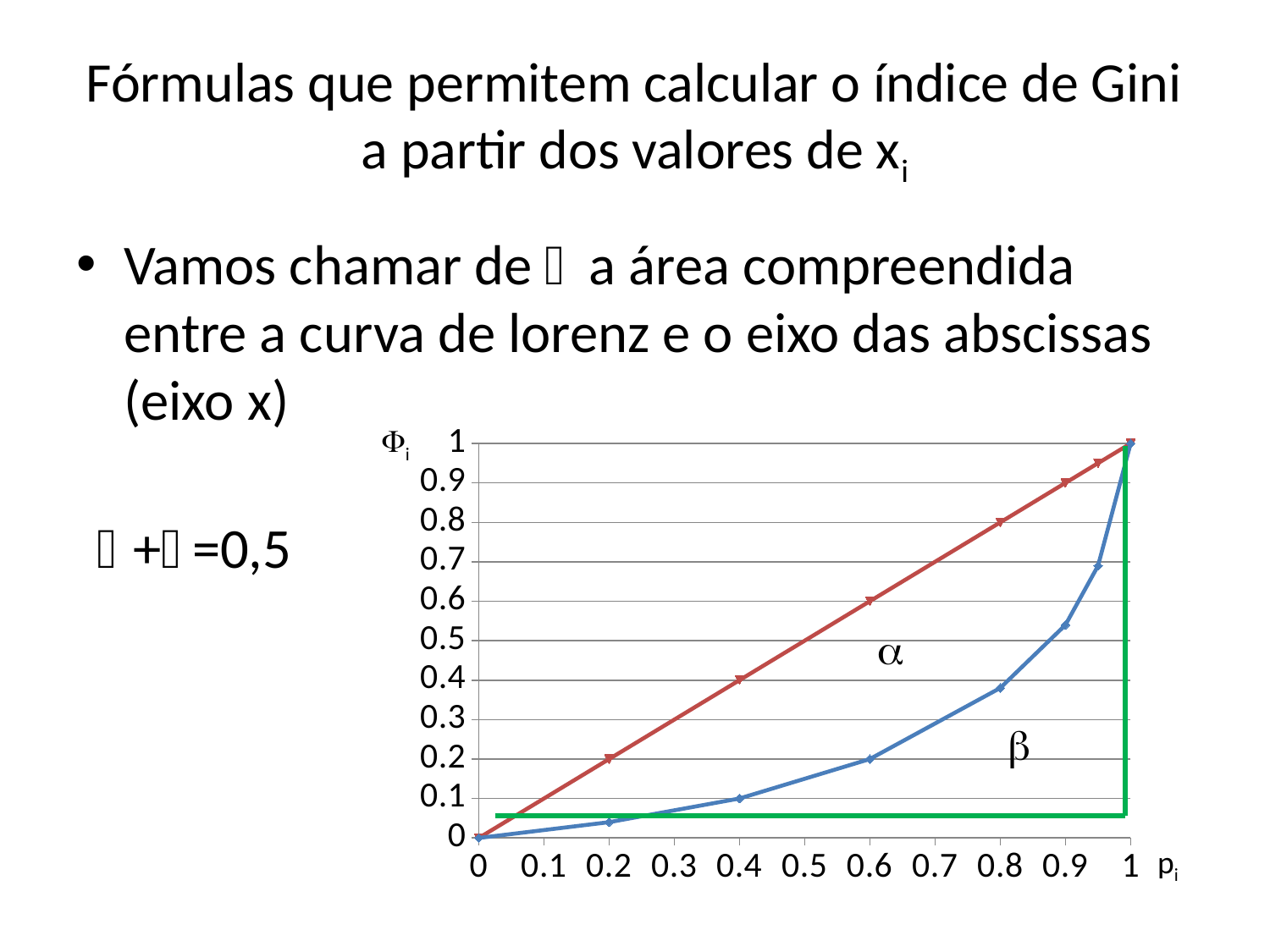
Is the value of the blue curve at p_i = 0.9 greater or less than 0.6? less What is the value of the red straight line at p_i = 0.6? 0.6 What is the label on the horizontal axis of the chart? p_i Does the blue curve rise or fall as p_i increases from 0 to 1? rise What is the value of the blue curve at p_i = 0.4? 0.1 Is the value of the blue curve at p_i = 0.8 greater or less than 0.4? less How many lines (series) are plotted on the chart? 2 At p_i = 0.8, which line has the higher value, the red line or the blue curve? the red line Is the value of the blue curve at p_i = 0.2 greater or less than 0.1? less What kind of chart is shown on the slide? line chart Which two Greek letters label the areas between the lines on the chart? α and β What is the value of the blue curve at p_i = 0.6? 0.2